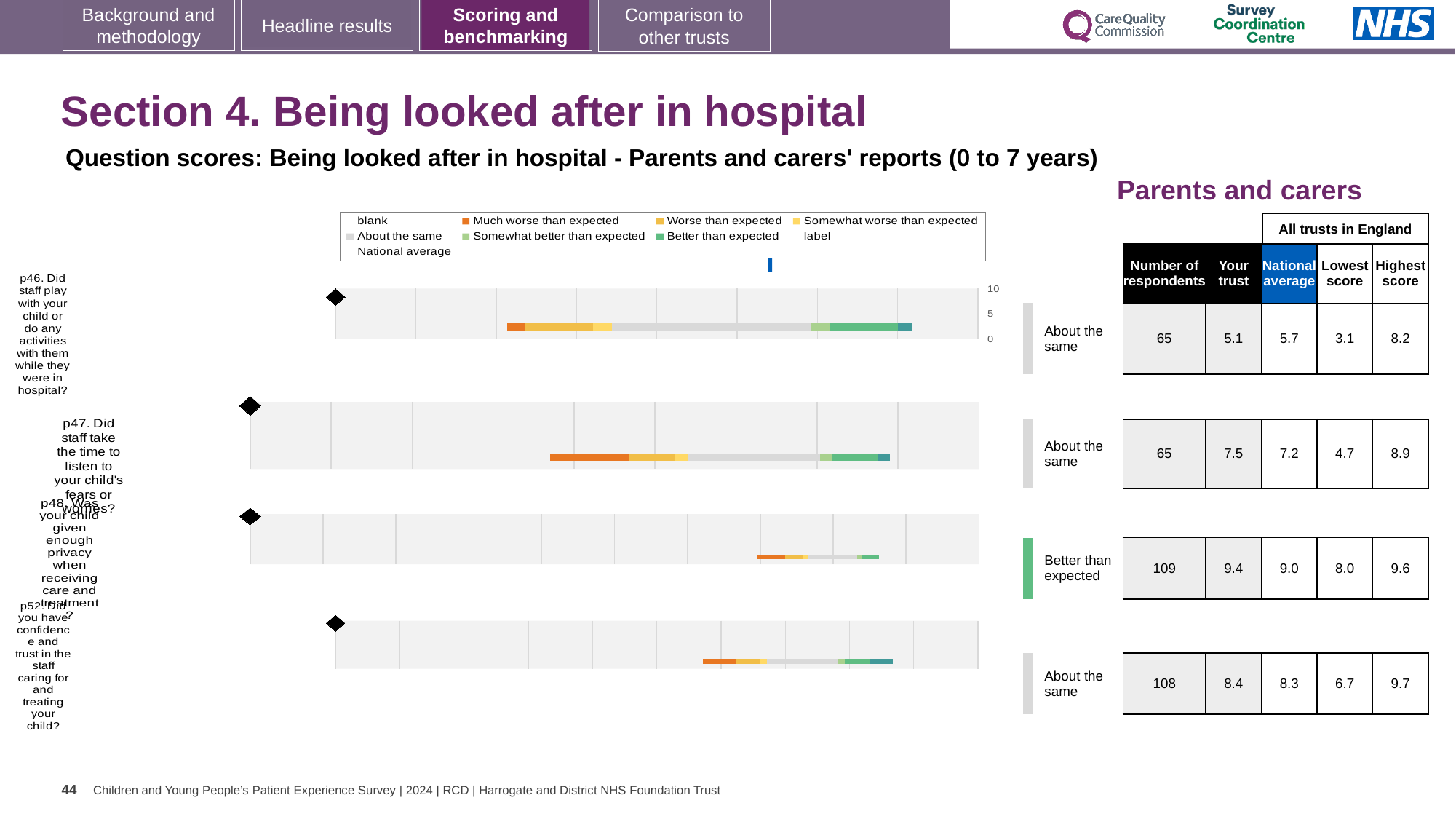
What is the highest score across all trusts in England for p52 (Did you have confidence and trust in the staff caring for and treating your child?)? 9.7 What is the 'Your trust' score for p46 (Did staff play with your child or do any activities with them while they were in hospital?)? 5.1 What kind of chart is used for each question in the 'Being looked after in hospital' section? bar chart What benchmark category is shown for p48 (Was your child given enough privacy when receiving care and treatment?)? Better than expected How many questions (charts) are shown on the slide? 4 For p47, which is larger: the 'Your trust' score or the national average? Your trust What is the lowest score across all trusts in England for p46? 3.1 How many respondents answered p48 (Was your child given enough privacy when receiving care and treatment?)? 109 Which question has the highest 'Your trust' score? p48 Which question has the lowest 'Your trust' score? p46 For p46, what is the difference between the national average and the 'Your trust' score? 0.6 What is the national average for p47 (Did staff take the time to listen to your child's fears or worries?)? 7.2